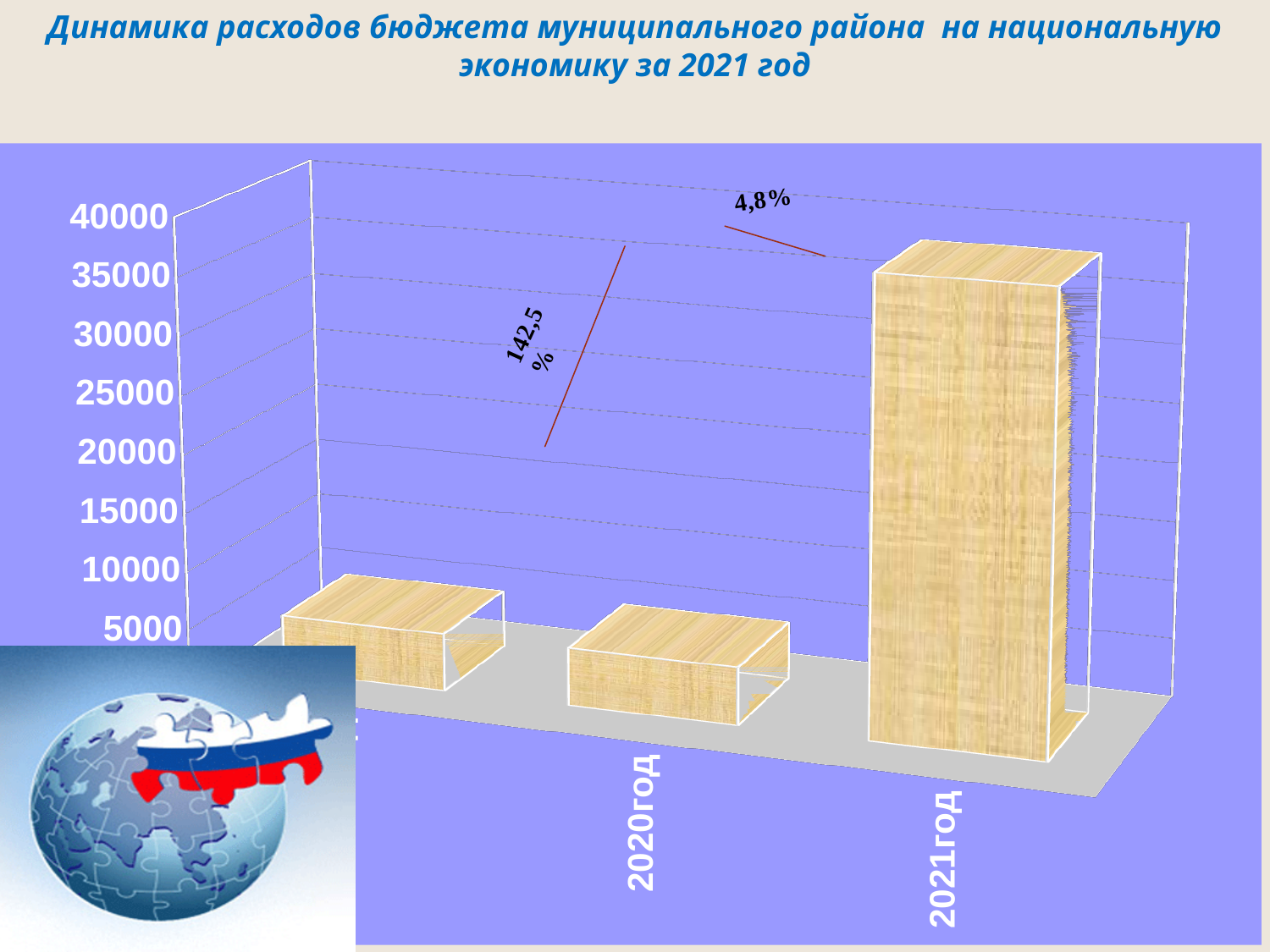
Is the value for 2020год greater or less than 15000? less What is the highest value shown on the vertical axis? 40000 What percentage label is written next to the 2021год bar? 4,8% Do the values rise or fall from 2020год to 2021год? rise How many bars are plotted in the chart? 3 What kind of chart is shown on the slide? bar chart Which bar is taller, 2020год or 2021год? 2021год Is the value for 2021год greater or less than 25000? greater Which category has the highest bar? 2021год